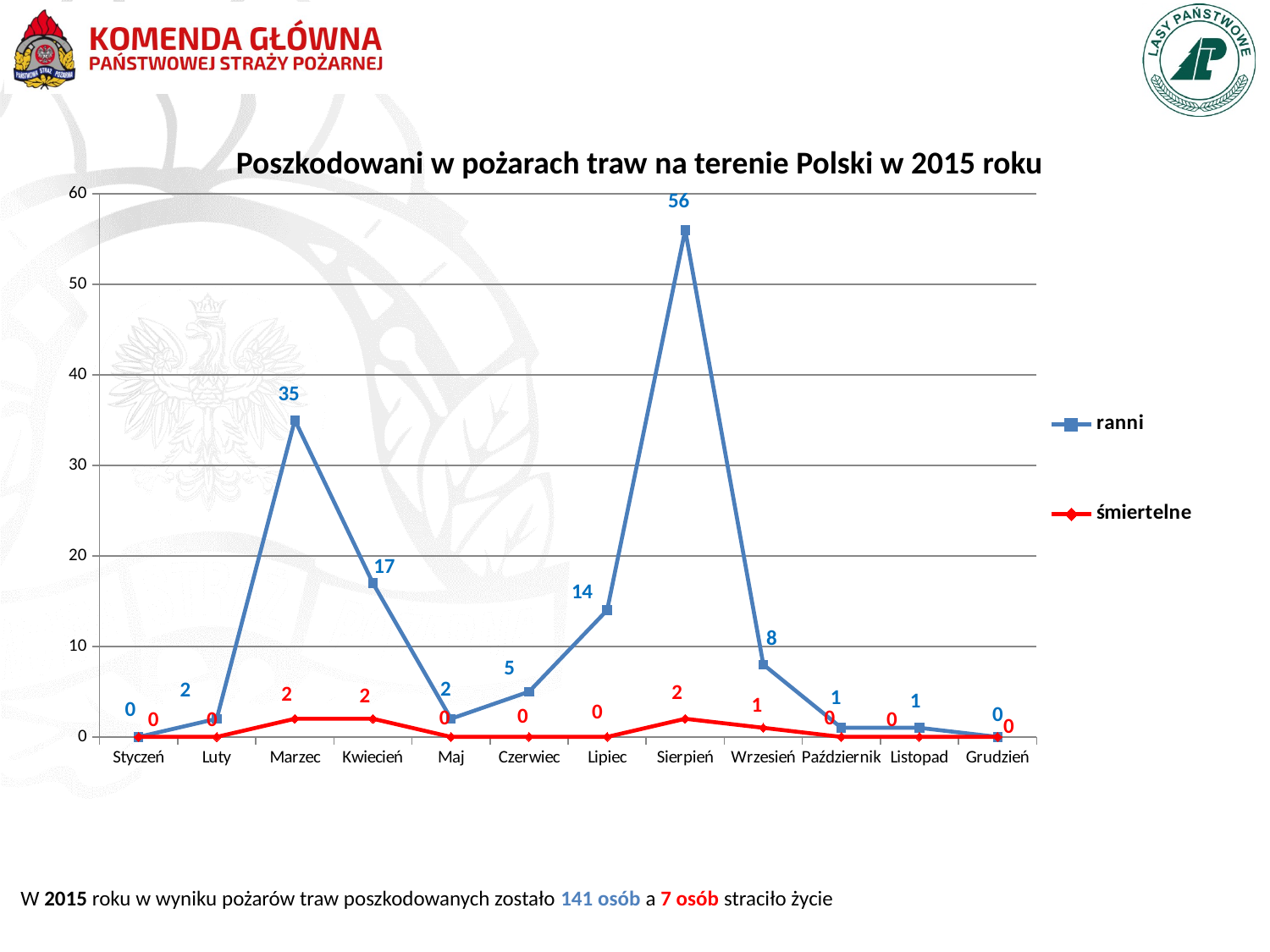
In which month is the 'ranni' value highest? Sierpień How many series does the legend list? 2 How many months (categories) are shown on the x axis? 12 What type of chart is shown on the slide? line chart What is the value of 'ranni' for Sierpień? 56 What is the difference between the 'ranni' values for Sierpień and Marzec? 21 What is the value of 'ranni' for Marzec? 35 What colour is the line for the 'śmiertelne' series? red What is the value of 'ranni' for Czerwiec? 5 What is the title of the chart? Poszkodowani w pożarach traw na terenie Polski w 2015 roku What is the value of 'śmiertelne' for Wrzesień? 1 Which is larger, the 'ranni' value for Kwiecień or for Lipiec? Kwiecień